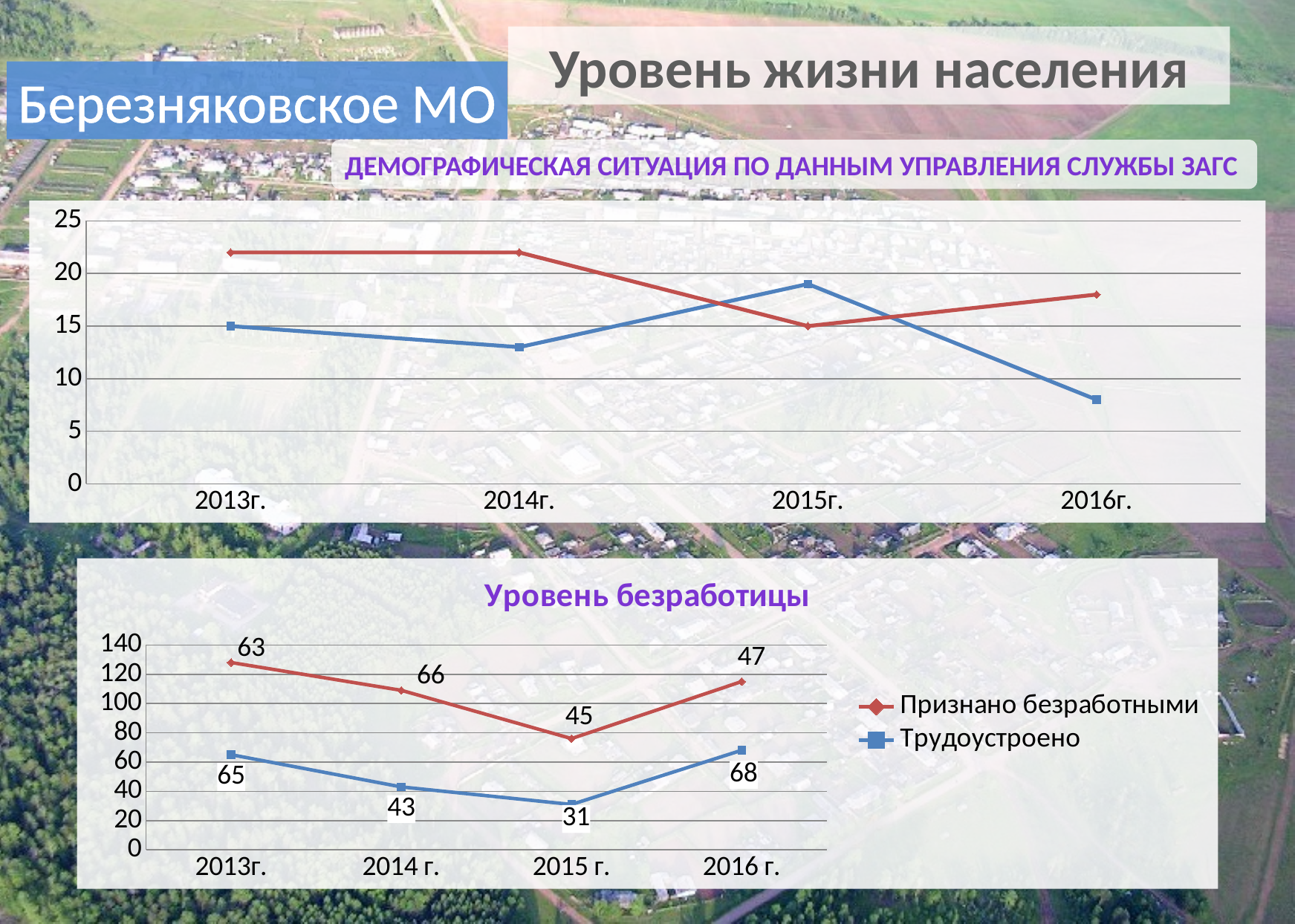
In the chart 'Уровень безработицы', what is the data label for 'Трудоустроено' in 2016 г.? 68 In the top chart, how many years are shown on the x axis? 4 In the top chart, which line is higher in 2016г., the red line or the blue line? the red line In the top chart, which line is higher in 2015г., the red line or the blue line? the blue line In the top chart, is the value of the blue line for 2015г. greater or less than 15? greater In the top chart, is the value of the red line for 2013г. greater or less than 20? greater In the chart 'Уровень безработицы', how many series does the legend list? 2 What is the title of the bottom chart? Уровень безработицы In the top chart, is the value of the blue line for 2016г. greater or less than 10? less In the chart 'Уровень безработицы', what is the difference between the labelled values of 'Трудоустроено' and 'Признано безработными' in 2016 г.? 21 What type of chart is the top chart on the slide? line chart In the chart 'Уровень безработицы', what is the data label for 'Признано безработными' in 2015 г.? 45